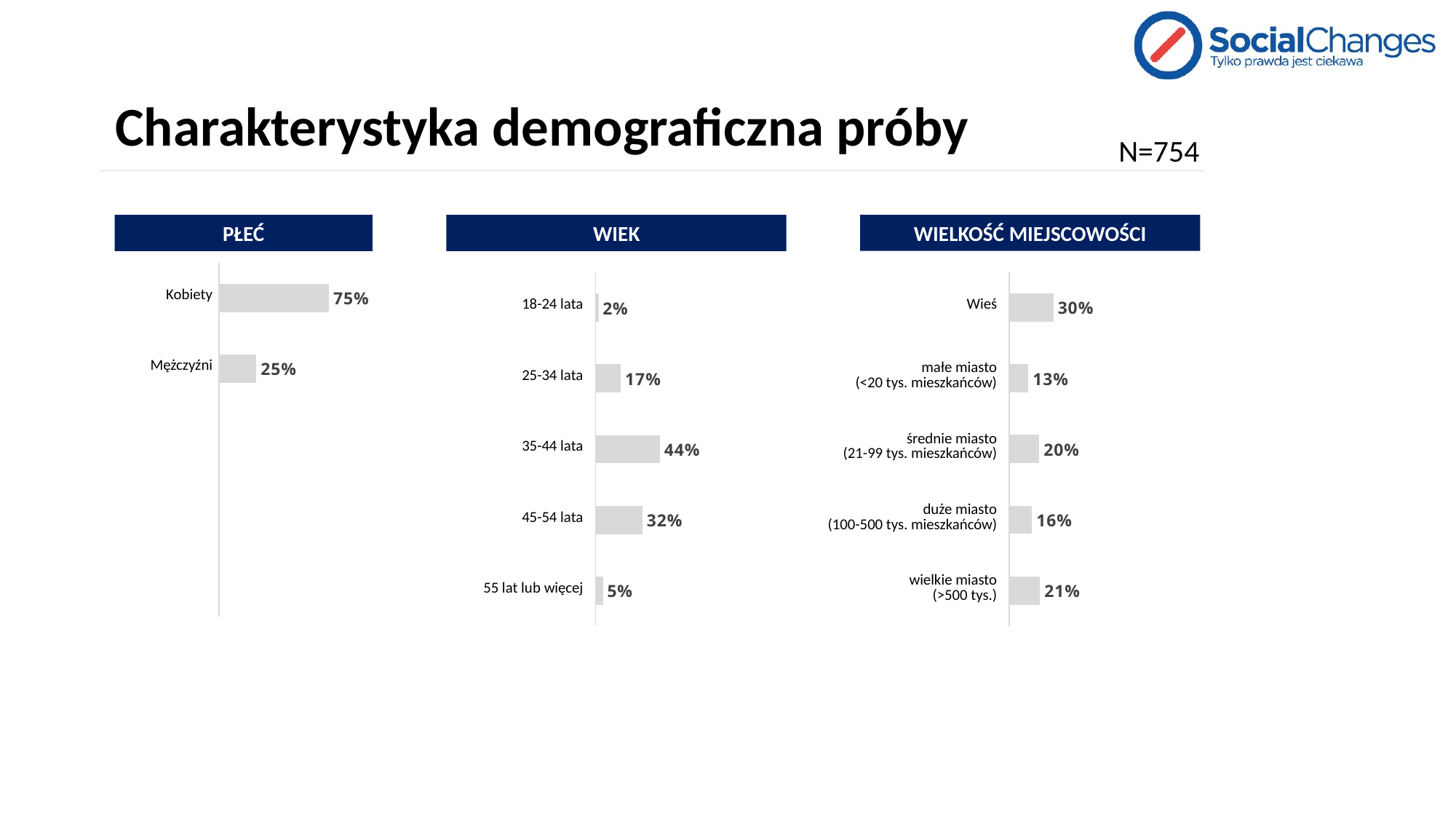
What kind of chart is the WIEK chart? bar chart In the PŁEĆ chart, what is the value for Kobiety? 75% In the WIELKOŚĆ MIEJSCOWOŚCI chart, what is the value for Wieś? 30% In the WIELKOŚĆ MIEJSCOWOŚCI chart, which category has the lowest value? małe miasto (<20 tys. mieszkańców) In the WIELKOŚĆ MIEJSCOWOŚCI chart, which is larger: średnie miasto or duże miasto? średnie miasto In the PŁEĆ chart, what is the difference between Kobiety and Mężczyźni? 50% In the WIEK chart, which age group has the lowest value? 18-24 lata In the WIEK chart, what is the value for 35-44 lata? 44% In the WIEK chart, how many age categories are shown? 5 What sample size (N) is shown on the slide? N=754 In the WIEK chart, what is the difference between 45-54 lata and 25-34 lata? 15% In the WIEK chart, which age group has the highest value? 35-44 lata